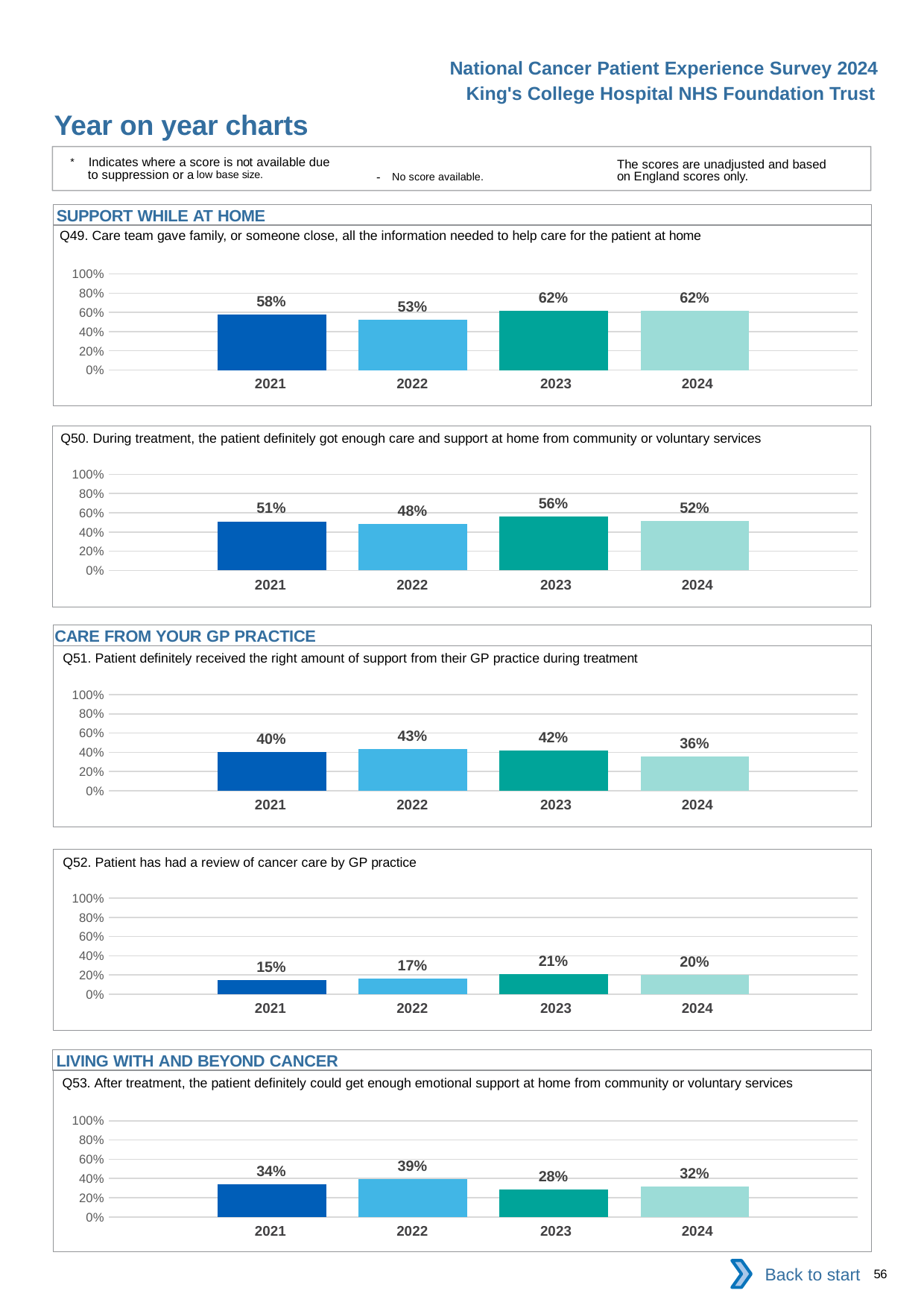
In the Q49 chart, which year has the lowest value? 2022 In the Q50 chart, what is the difference between the 2023 and 2022 values? 8 percentage points In the Q51 chart, what is the value for 2024? 36% In the Q53 chart, which year has the lowest value? 2023 In the Q49 chart, what is the value for 2021? 58% In the Q50 chart, what is the value for 2023? 56% In the Q51 chart, which year has the highest value? 2022 In the Q52 chart, which is larger, the value for 2023 or the value for 2024? 2023 In the Q52 chart, is the value for 2021 greater or less than 20%? less What type of chart is used for Q49? Bar chart How many years are shown in the Q52 chart? 4 In the Q53 chart, what is the value for 2022? 39%